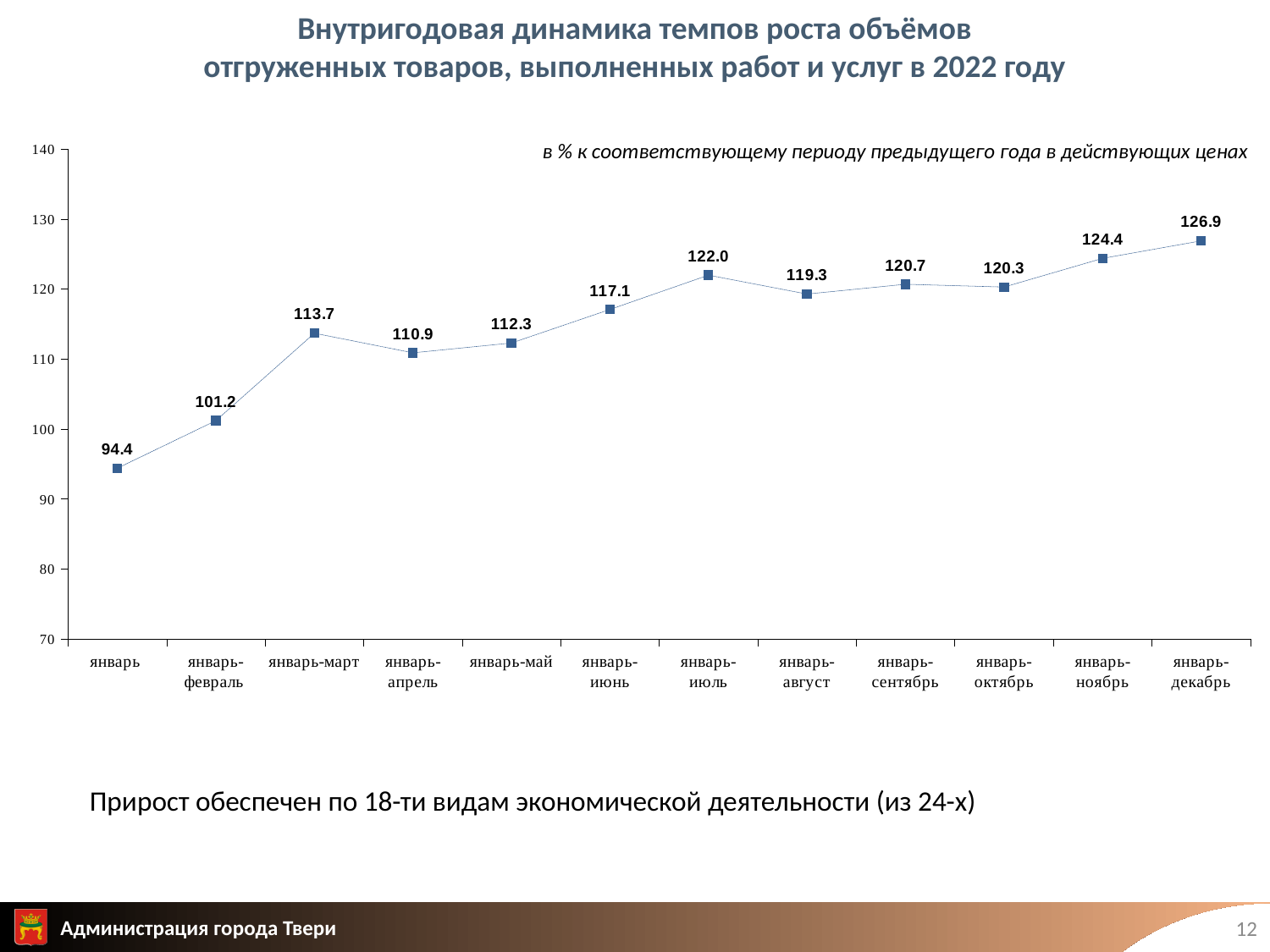
What is the difference between the values for январь-март and январь-апрель? 2.8 What is the value for январь-декабрь? 126.9 Which is larger, the value for январь-июль or the value for январь-август? январь-июль What is the value for январь-август? 119.3 Which period has the lowest value? январь What kind of chart is shown? line chart What is the difference between the values for январь-декабрь and январь? 32.5 What is the value for январь-март? 113.7 Is the value for январь-февраль greater or less than 100? greater Do the values generally rise or fall from январь to январь-декабрь? rise Which period has the highest value? январь-декабрь How many periods are plotted on the x axis? 12